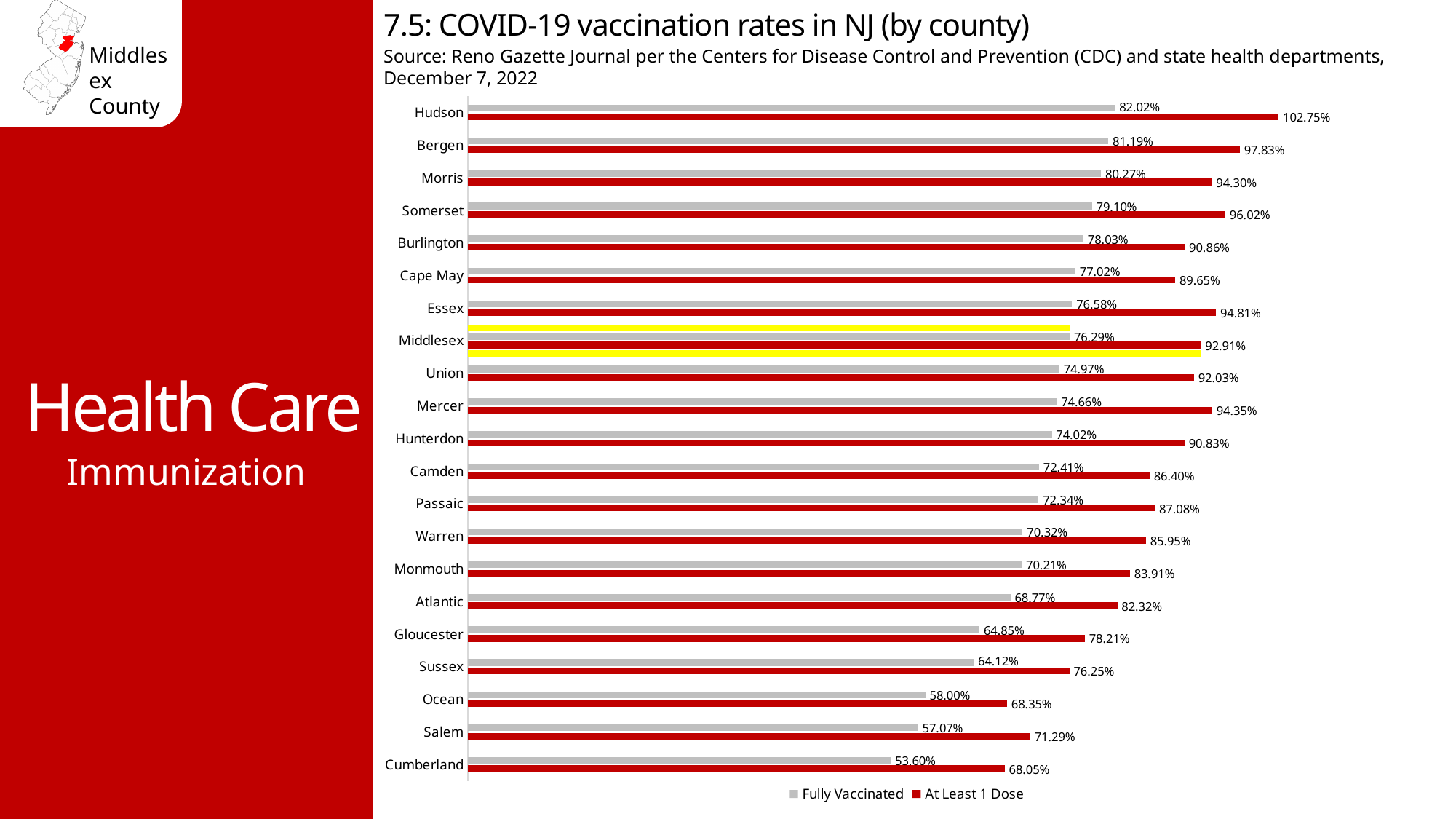
What is the At Least 1 Dose rate for Hudson County? 102.75% Which county has the lowest At Least 1 Dose rate? Cumberland How many series does the legend list? 2 Which county has the highest Fully Vaccinated rate? Hudson What is the Fully Vaccinated rate for Middlesex County? 76.29% Which county has a higher At Least 1 Dose rate, Essex or Burlington? Essex What is the difference between the At Least 1 Dose rate and the Fully Vaccinated rate for Middlesex County? 16.62 percentage points What is the At Least 1 Dose rate for Cumberland County? 68.05% Which county is highlighted in yellow on the chart? Middlesex What type of chart is shown on the slide? Bar chart How many counties are shown in the chart? 21 Which county has the lowest Fully Vaccinated rate? Cumberland